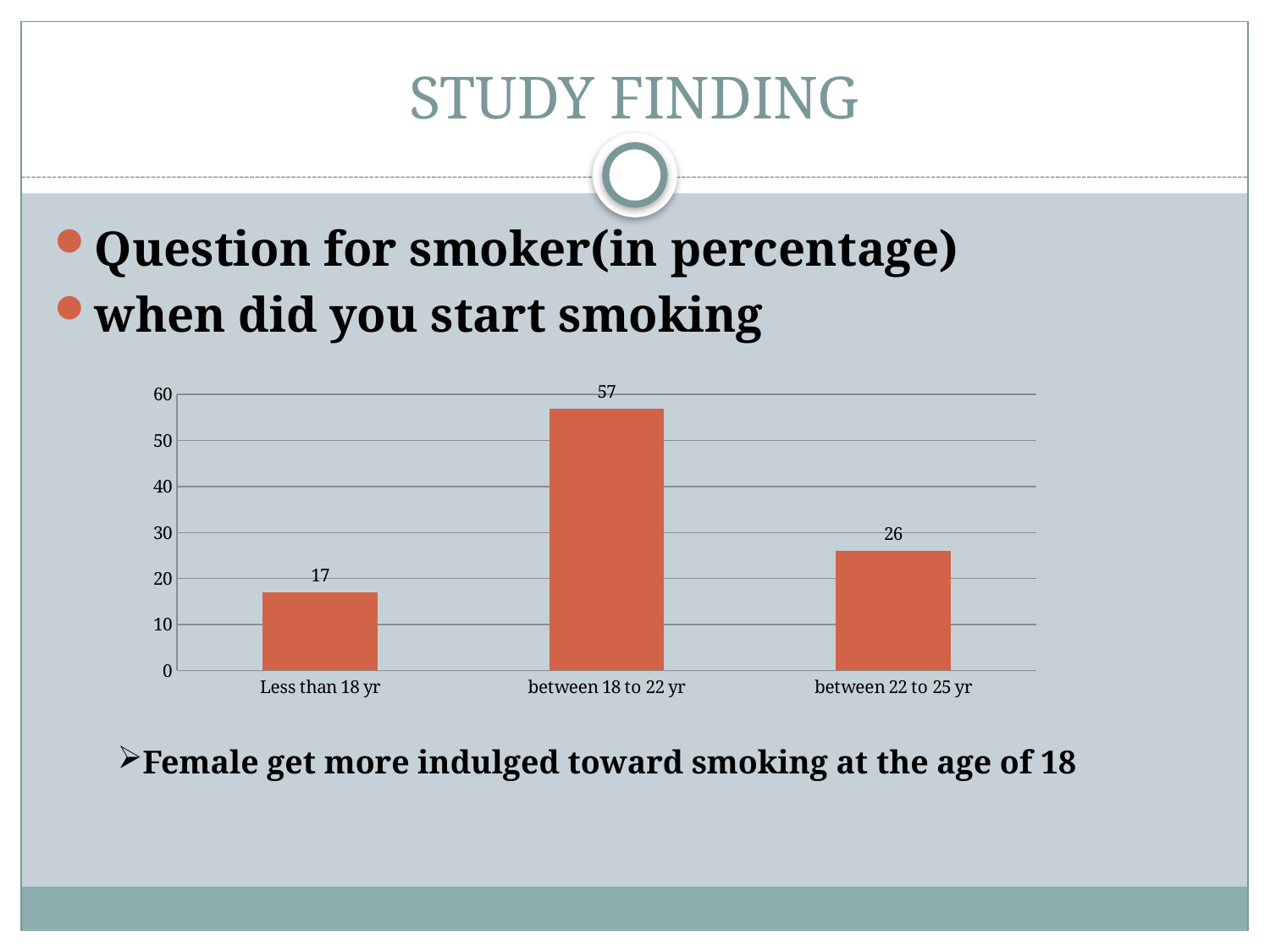
What is the highest value shown on the y axis of the chart? 60 What is the difference between the values for "between 22 to 25 yr" and "Less than 18 yr"? 9 What is the value for "between 22 to 25 yr"? 26 What is the value for "Less than 18 yr"? 17 Which is larger, the value for "Less than 18 yr" or the value for "between 22 to 25 yr"? between 22 to 25 yr What is the difference between the values for "between 18 to 22 yr" and "between 22 to 25 yr"? 31 What kind of chart is shown on the slide? bar chart What is the value for "between 18 to 22 yr"? 57 How many categories are shown on the x axis of the chart? 3 Is the value for "between 18 to 22 yr" greater or less than 50? greater Which category has the lowest value? Less than 18 yr Which category has the highest value? between 18 to 22 yr